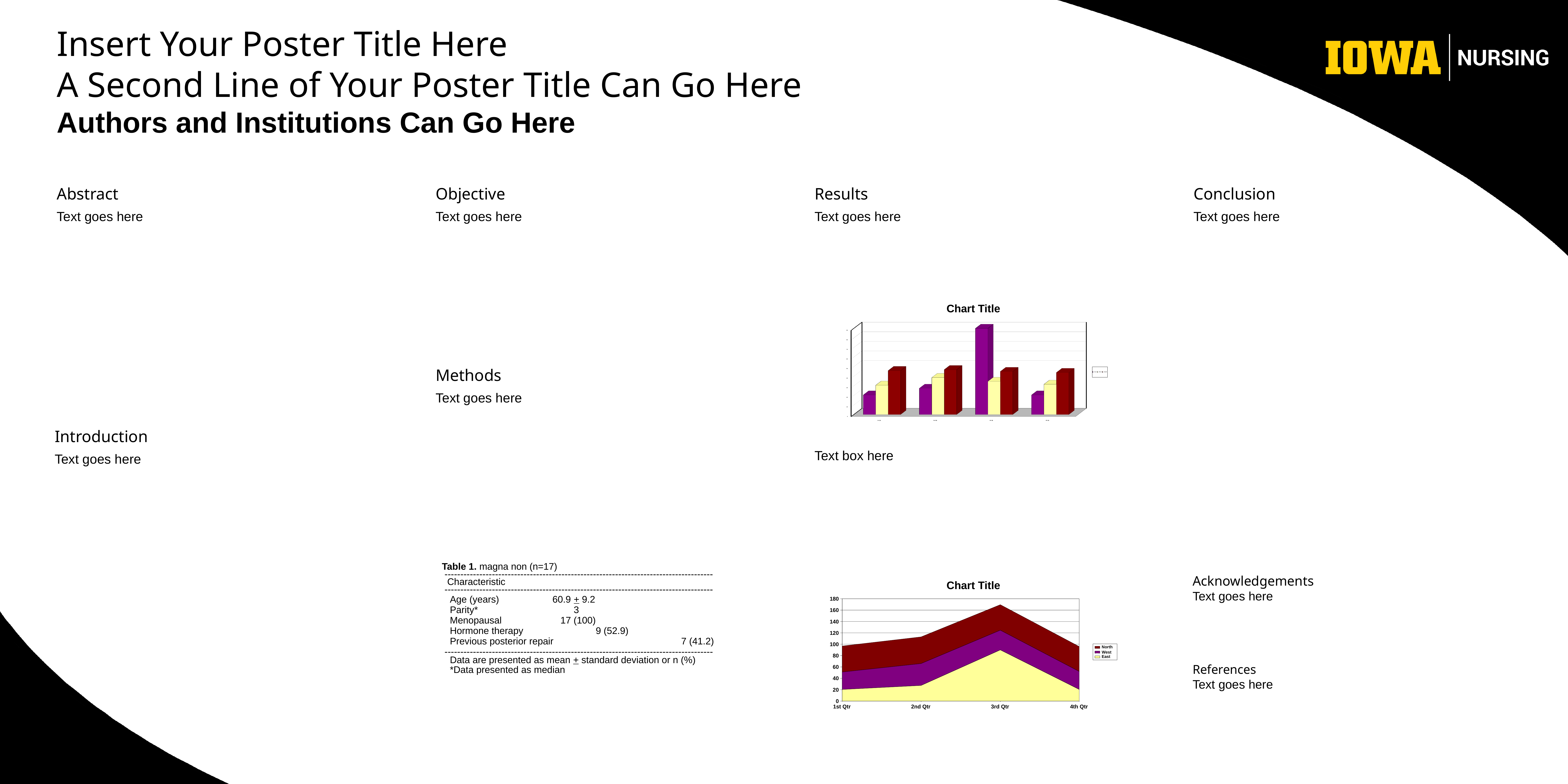
In the lower chart, does the East series rise or fall from 1st Qtr to 3rd Qtr? Rise In the lower chart, is the stacked total for 1st Qtr greater or less than 120? less How many quarters are shown on the x axis of the lower chart? 4 How many series does the legend of the lower chart list? 3 Which series are listed in the legend of the lower chart? North, West, East In the lower chart, which colour represents the East series? Yellow How many groups of bars are shown in the upper chart? 4 In the lower chart, is the value for East at 3rd Qtr greater or less than 80? greater In the lower chart, is the stacked total for 3rd Qtr greater or less than 140? greater What kind of chart is the upper chart on the slide? Bar chart In the lower chart, which quarter has the highest stacked total? 3rd Qtr What kind of chart is the lower chart on the slide? Area chart